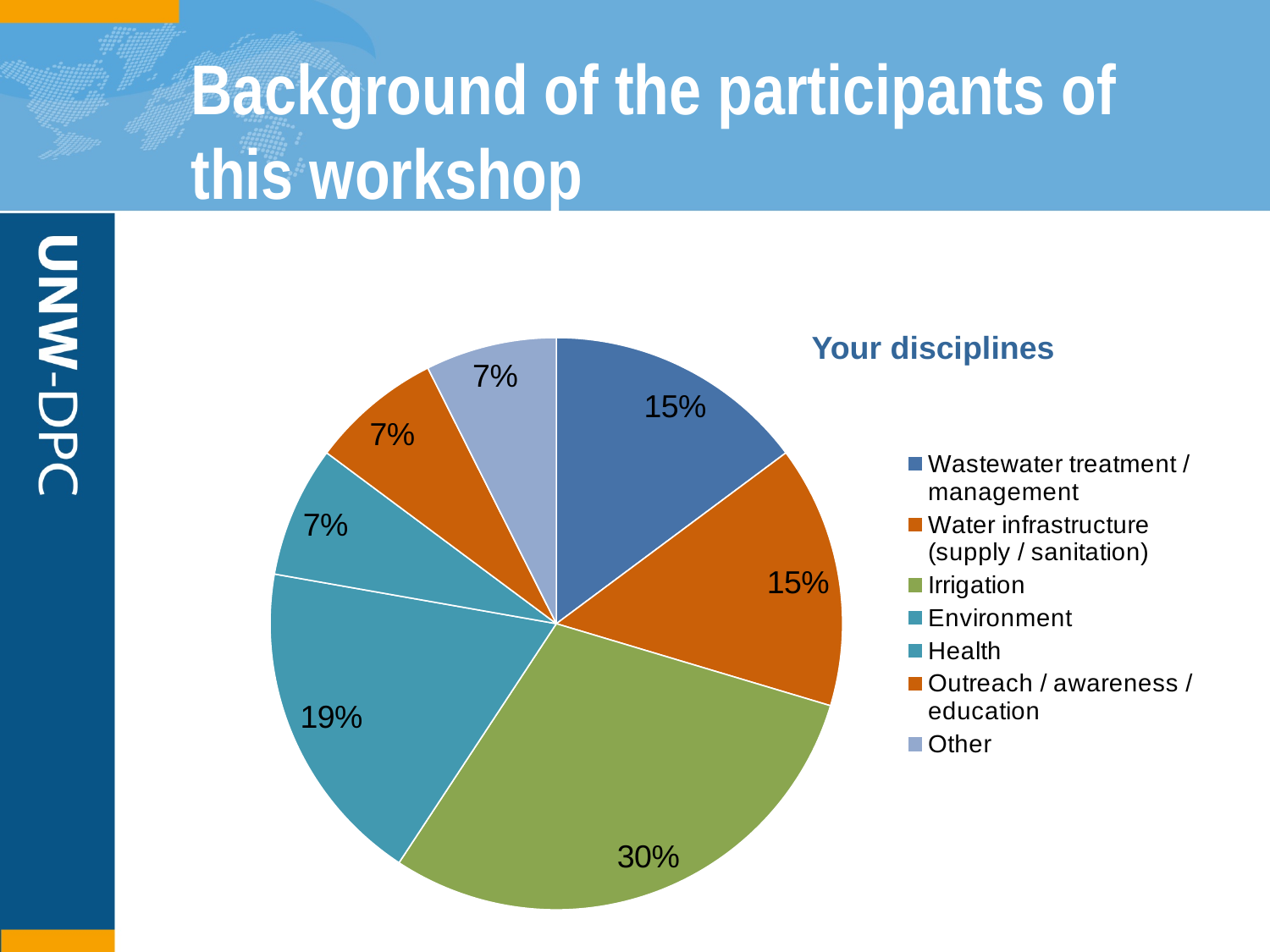
What is the value shown for Environment? 19% What kind of chart is shown on the slide? Pie chart What is the value shown for Water infrastructure (supply / sanitation)? 15% How many categories are shown in the pie chart? 7 Which discipline has the largest slice of the pie? Irrigation What share of the pie does Irrigation represent? 30% What is the difference in percentage points between Environment and Health? 12 What is the value shown for Other? 7% What is the title of the chart? Your disciplines What is the difference in percentage points between Irrigation and Environment? 11 What is the value shown for Wastewater treatment / management? 15% Which is larger, the slice for Irrigation or the slice for Environment? Irrigation